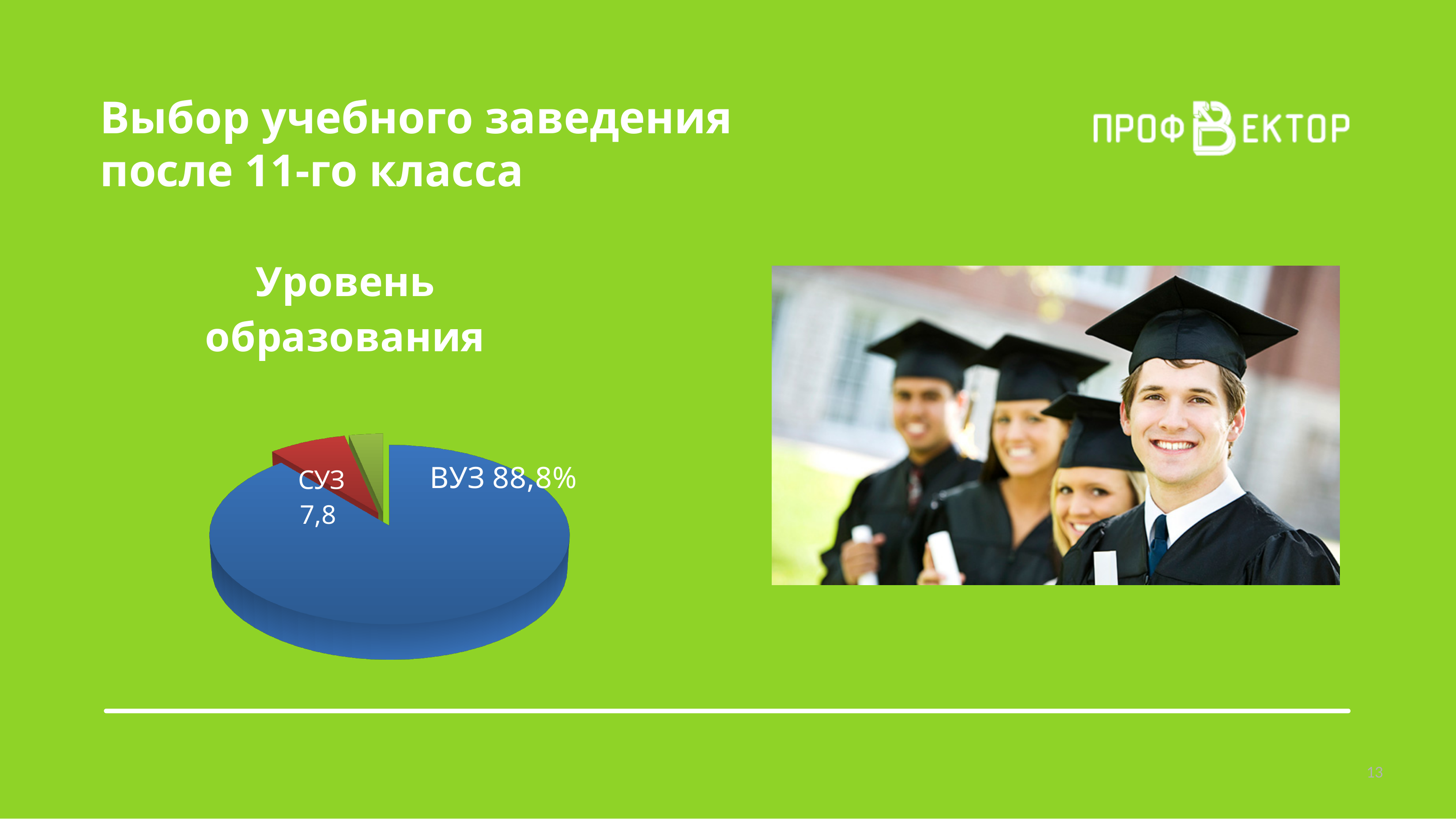
Which category has the largest slice of the pie? ВУЗ How many slices does the pie chart have? 3 What value is shown for СУЗ in the pie chart? 7,8 Which is larger, the slice for ВУЗ or the slice for СУЗ? ВУЗ What kind of chart is shown on the slide? pie chart By how much does the ВУЗ value exceed the СУЗ value? 81 What share of the pie does ВУЗ have? 88,8% What colour is the ВУЗ slice in the pie chart? blue What is the title of the chart on the slide? Уровень образования